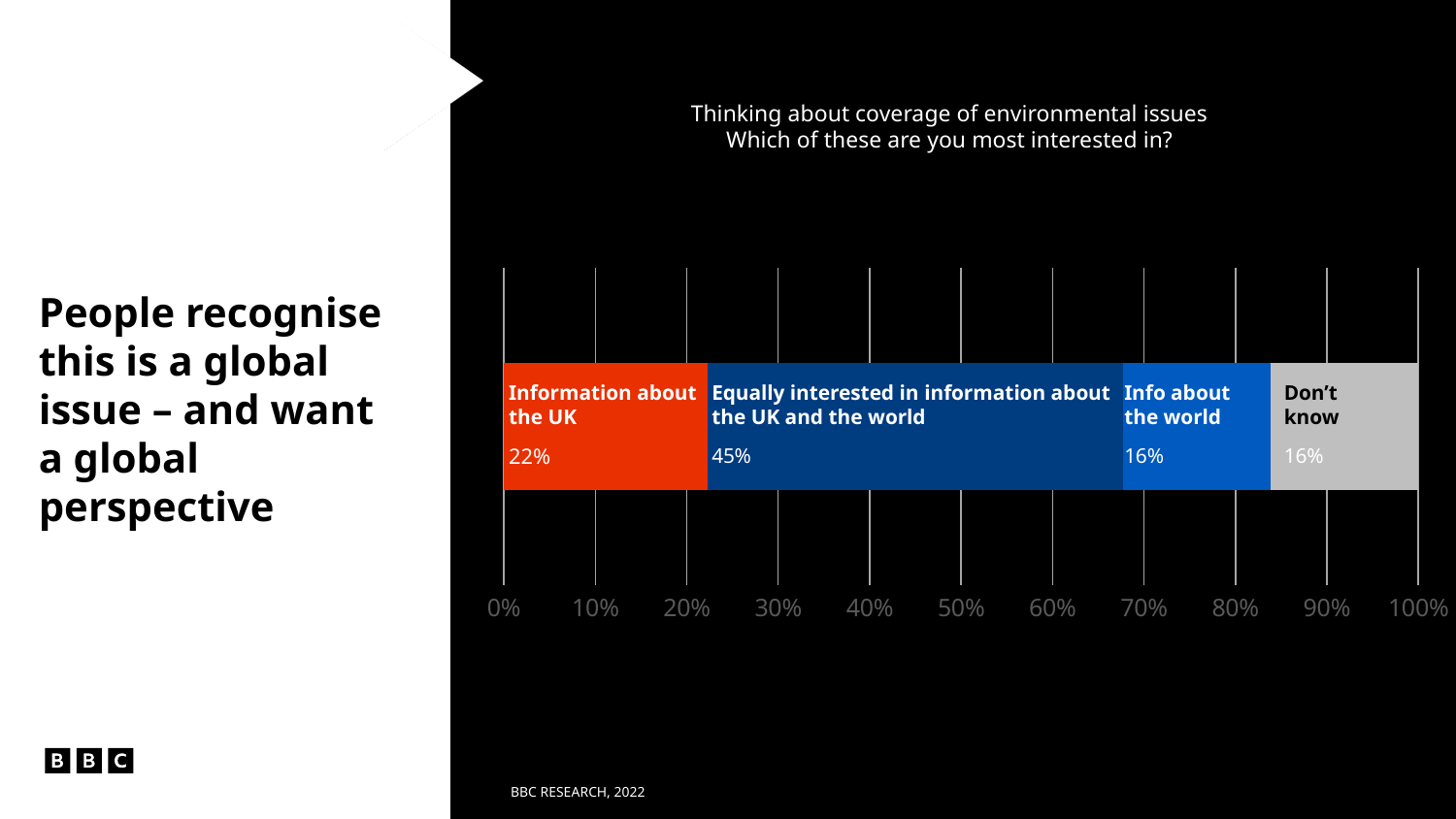
What percentage of respondents are equally interested in information about the UK and the world? 45% What percentage of respondents answered 'Don't know'? 16% What percentage of respondents are most interested in information about the UK? 22% What kind of chart is shown on the slide? Stacked bar chart What is the total of all segments in the stacked bar? 99% Which is larger: the share for 'Information about the UK' or the share for 'Info about the world'? Information about the UK How many response segments are shown in the bar? 4 Which response has the largest share? Equally interested in information about the UK and the world What percentage of respondents are most interested in info about the world? 16% What is the difference in percentage points between 'Information about the UK' and 'Info about the world'? 6 Is the value for 'Equally interested in information about the UK and the world' greater or less than 40%? greater What is the difference in percentage points between 'Equally interested in information about the UK and the world' and 'Information about the UK'? 23